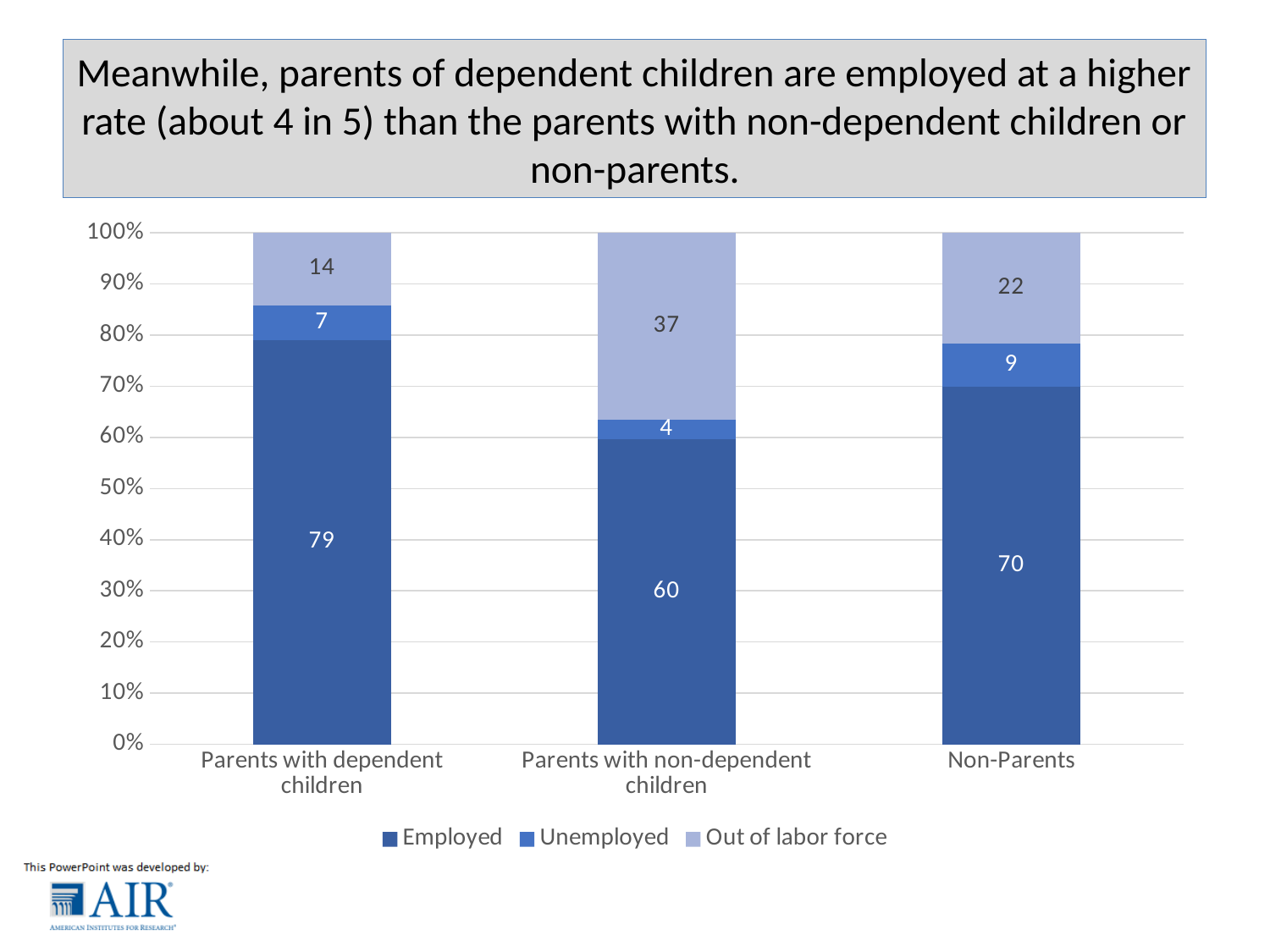
Which series is shown in the lightest blue colour? Out of labor force How many series does the legend list? 3 Which is larger: the Out of labor force value for Non-Parents or for Parents with dependent children? Non-Parents What is the Out of labor force value for Parents with non-dependent children? 37 What is the total of the stacked bar for Parents with non-dependent children? 101 Which category has the highest Employed value? Parents with dependent children What is the Unemployed value for Non-Parents? 9 What kind of chart is shown on the slide? Stacked bar chart What is the difference between the Employed values for Parents with dependent children and Non-Parents? 9 What is the Employed value for Parents with dependent children? 79 Which category has the lowest Unemployed value? Parents with non-dependent children How many categories are shown on the x axis? 3